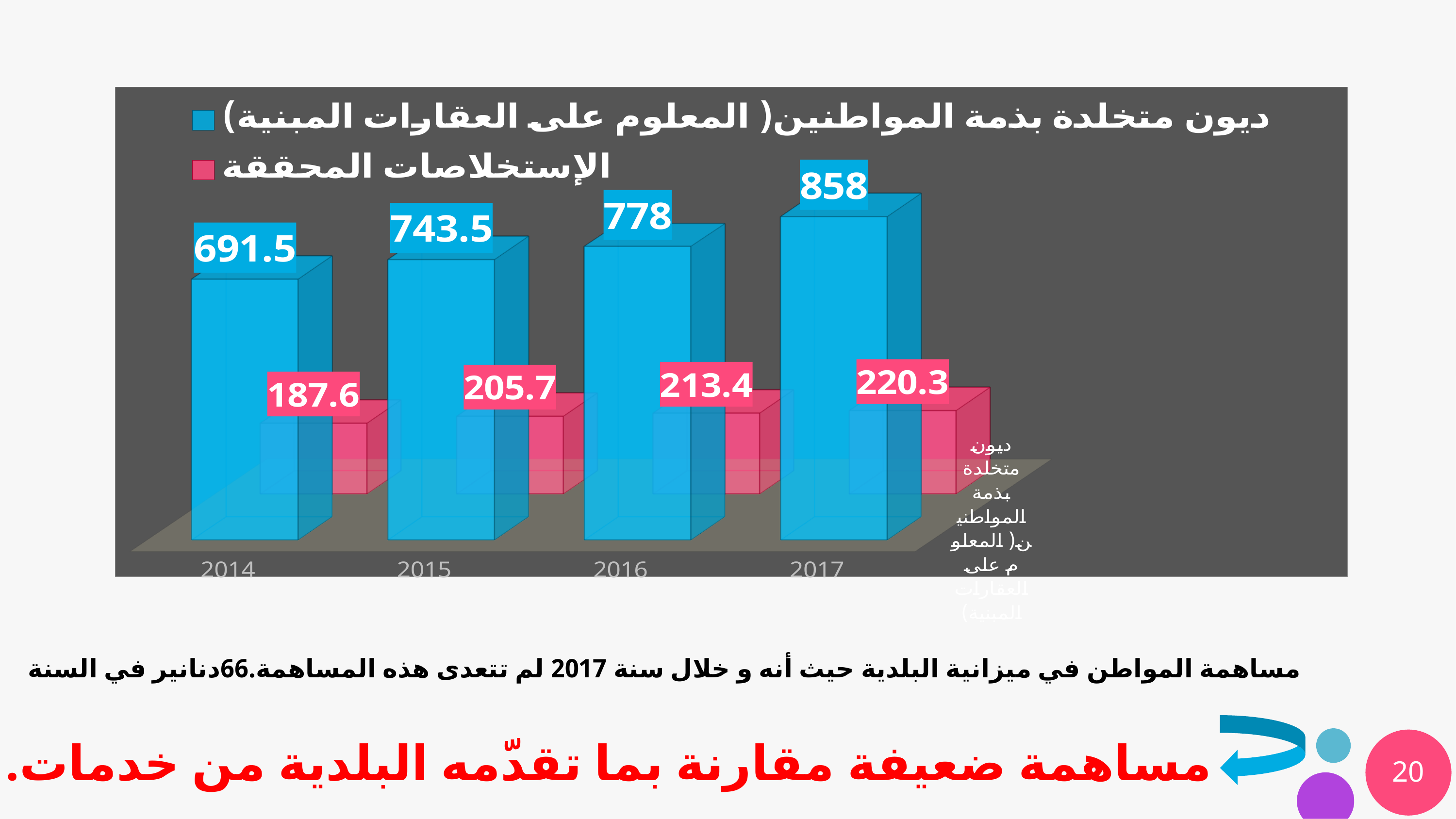
What is the difference between the blue series values for 2017 and 2016? 80 What is the value of the blue series (ديون متخلدة بذمة المواطنين) for 2014? 691.5 In which year is the blue series (ديون متخلدة بذمة المواطنين) highest? 2017 What is the value of the pink series (الإستخلاصات المحققة) for 2015? 205.7 What is the difference between the blue and pink series values in 2014? 503.9 In which year is the pink series (الإستخلاصات المحققة) lowest? 2014 How many years are shown on the x axis? 4 Which is larger in 2015: the blue series (ديون متخلدة بذمة المواطنين) or the pink series (الإستخلاصات المحققة)? the blue series (ديون متخلدة بذمة المواطنين) What is the value of the pink series (الإستخلاصات المحققة) for 2016? 213.4 How many series does the legend list? 2 What kind of chart is shown on the slide? bar chart What is the value of the blue series (ديون متخلدة بذمة المواطنين) for 2017? 858